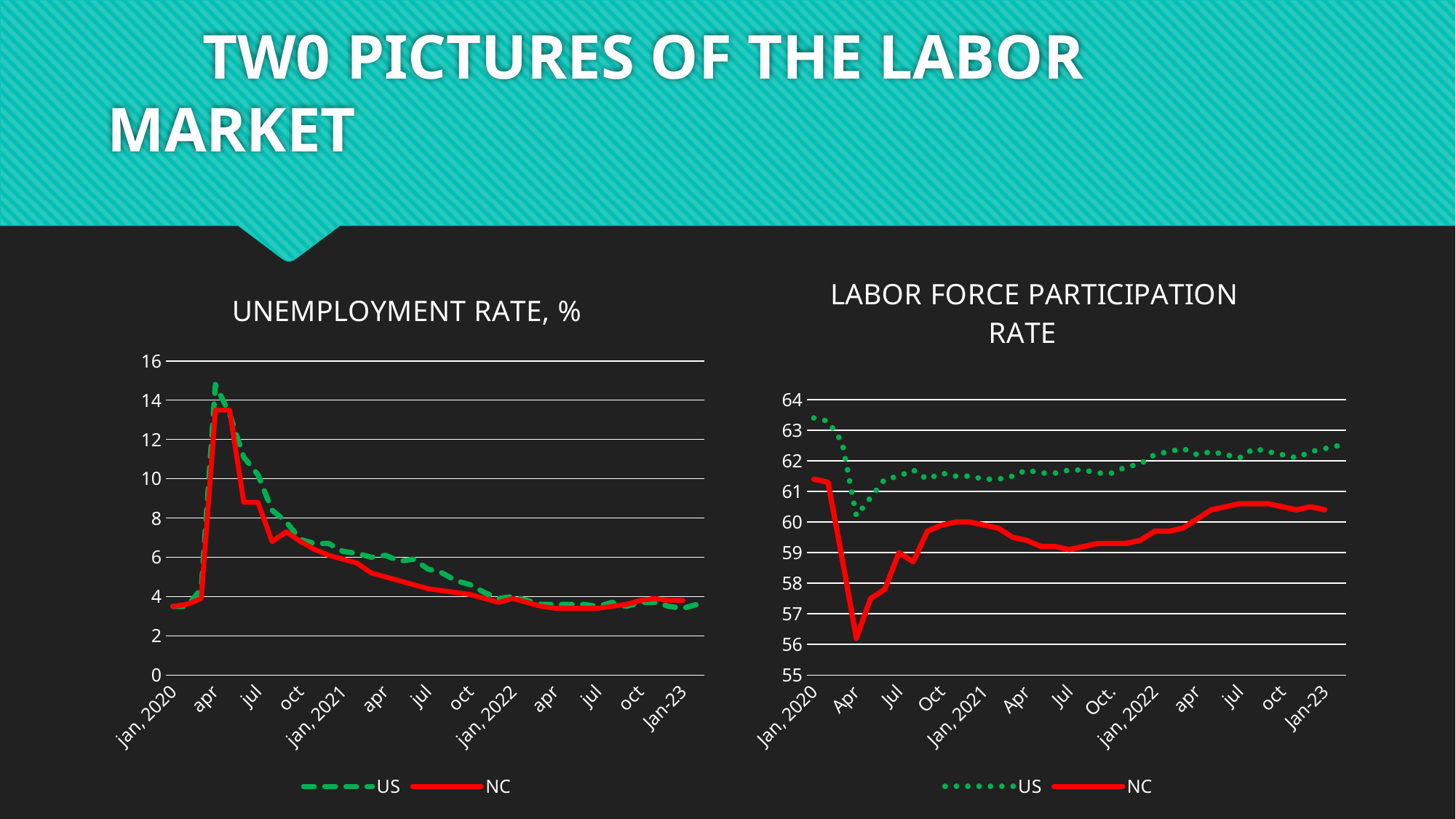
What kind of chart is the Unemployment Rate, % chart? line chart In the Unemployment Rate, % chart, is the value for NC in Jan, 2020 greater or less than 4? less In the Unemployment Rate, % chart, which series is drawn as a dashed green line? US In the Unemployment Rate, % chart, is the peak value for US greater or less than 14? greater In the Unemployment Rate, % chart, is the peak value for NC greater or less than 12? greater In the Labor Force Participation Rate chart, which series is higher at Jan-23, US or NC? US In the Unemployment Rate, % chart, which series has the higher peak in April 2020, US or NC? US How many series does the legend of the Labor Force Participation Rate chart list? 2 In the Unemployment Rate, % chart, do the values rise or fall from April 2020 to Jan-23? fall